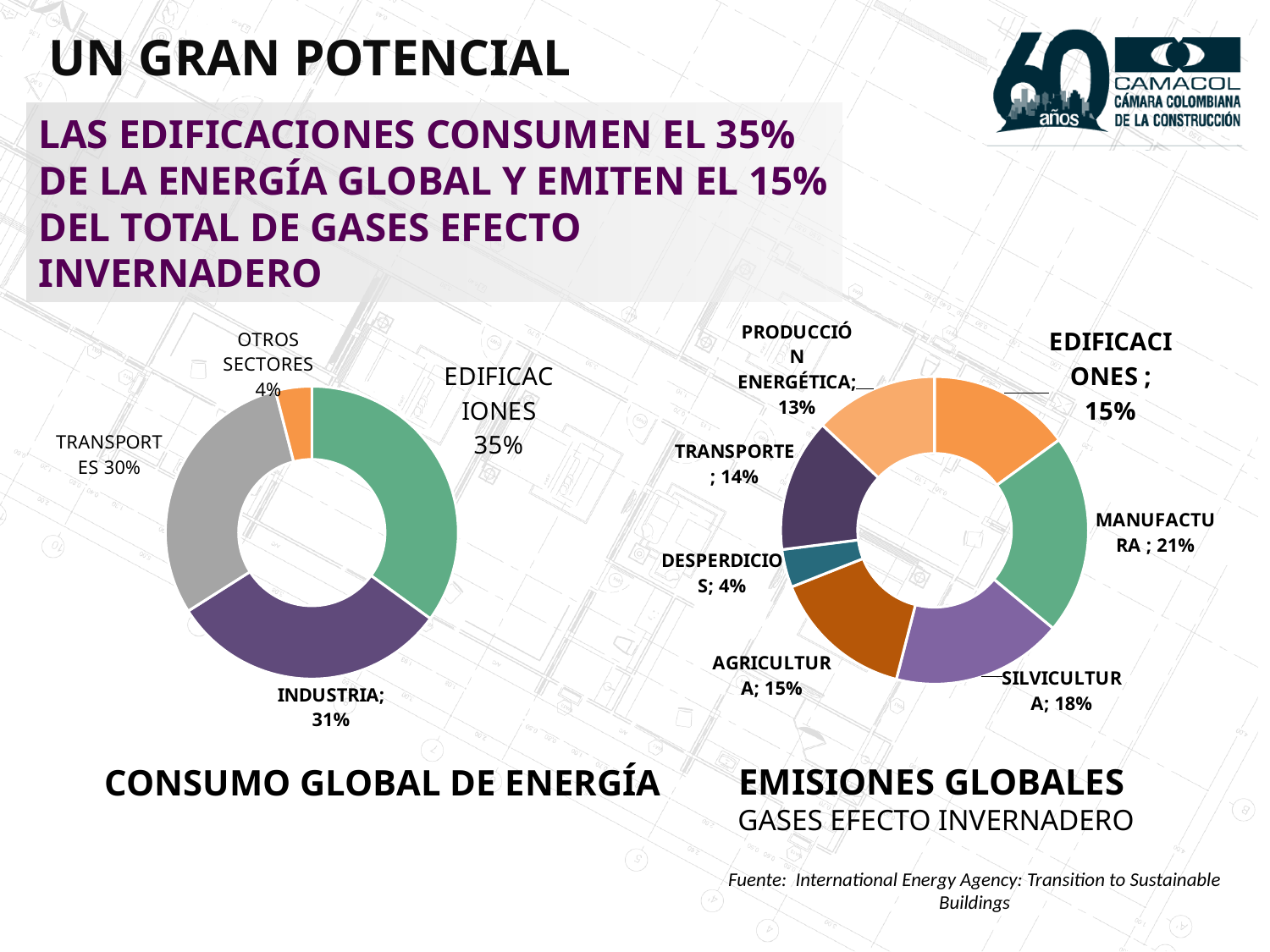
In the 'EMISIONES GLOBALES' chart, which is larger, the share for TRANSPORTE or the share for PRODUCCIÓN ENERGÉTICA? TRANSPORTE In the 'EMISIONES GLOBALES' chart, which category has the smallest share? DESPERDICIOS In the 'EMISIONES GLOBALES' chart, which category has the largest share? MANUFACTURA In the 'CONSUMO GLOBAL DE ENERGÍA' chart, what is the difference between the shares of EDIFICACIONES and OTROS SECTORES? 31% In the 'EMISIONES GLOBALES' chart, how many categories are shown? 7 In the 'CONSUMO GLOBAL DE ENERGÍA' chart, what share is shown for INDUSTRIA? 31% In the 'EMISIONES GLOBALES' chart, what share is shown for SILVICULTURA? 18% In the 'CONSUMO GLOBAL DE ENERGÍA' chart, which category has the smallest share? OTROS SECTORES What kind of chart is the 'CONSUMO GLOBAL DE ENERGÍA' chart? Doughnut (pie) chart In the 'CONSUMO GLOBAL DE ENERGÍA' chart, what share is shown for EDIFICACIONES? 35% In the 'CONSUMO GLOBAL DE ENERGÍA' chart, how many categories are shown? 4 In the 'EMISIONES GLOBALES' chart, what share is shown for MANUFACTURA? 21%